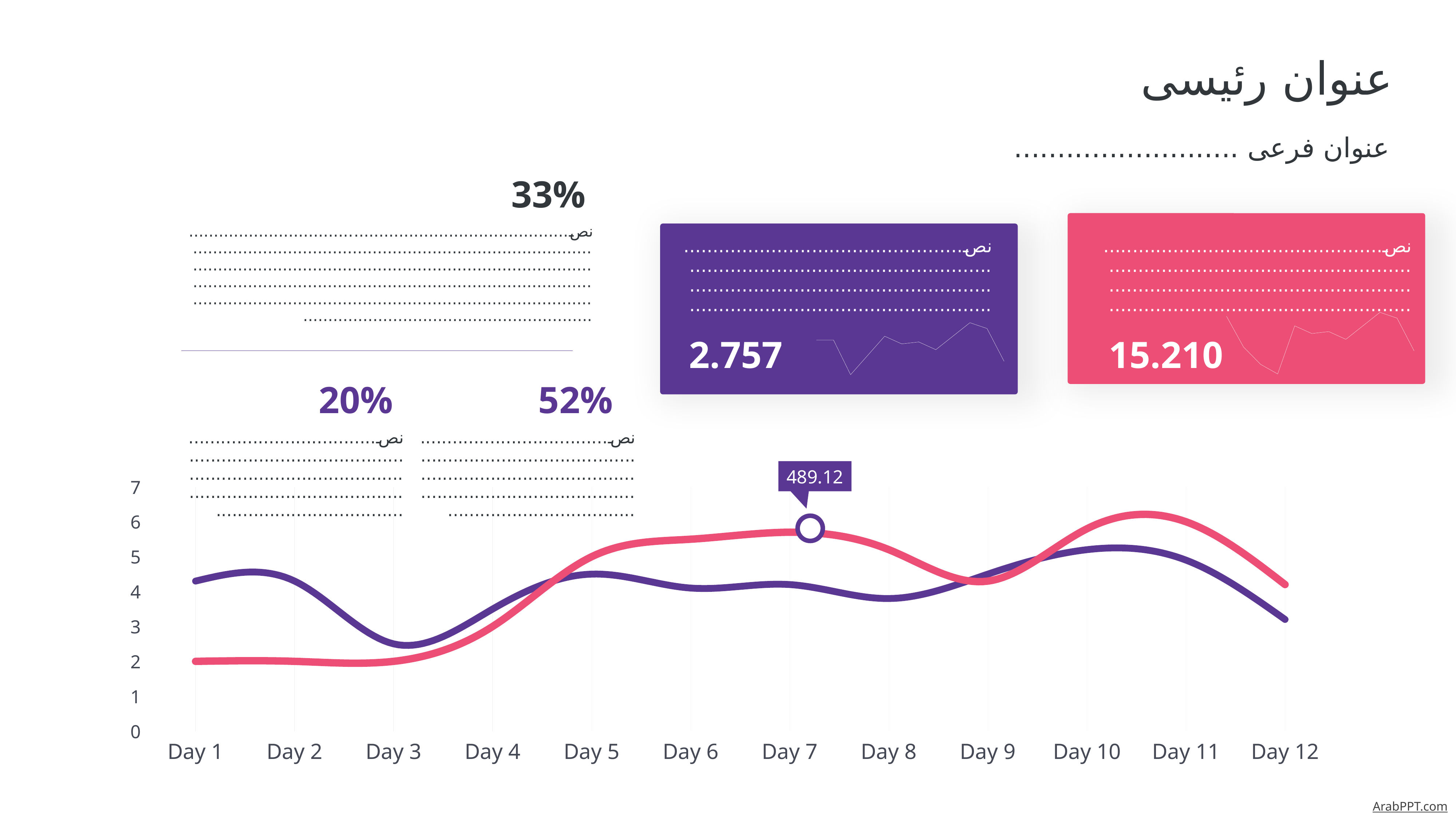
On the line chart, is the purple line's value at Day 12 greater or less than 4? less On the line chart, is the pink line's value at Day 12 greater or less than 4? greater How many days are shown on the x axis of the line chart? 12 How many lines are plotted on the line chart? 2 On the line chart, which line is higher at Day 7, the purple line or the pink line? pink line What kind of chart is shown at the bottom of the slide? line chart On the line chart, is the purple line's value at Day 1 greater or less than 4? greater On the line chart, does the pink line rise or fall from Day 3 to Day 7? rise On the line chart, at which day does the purple line reach its lowest point? Day 3 On the line chart, which line is higher at Day 1, the purple line or the pink line? purple line